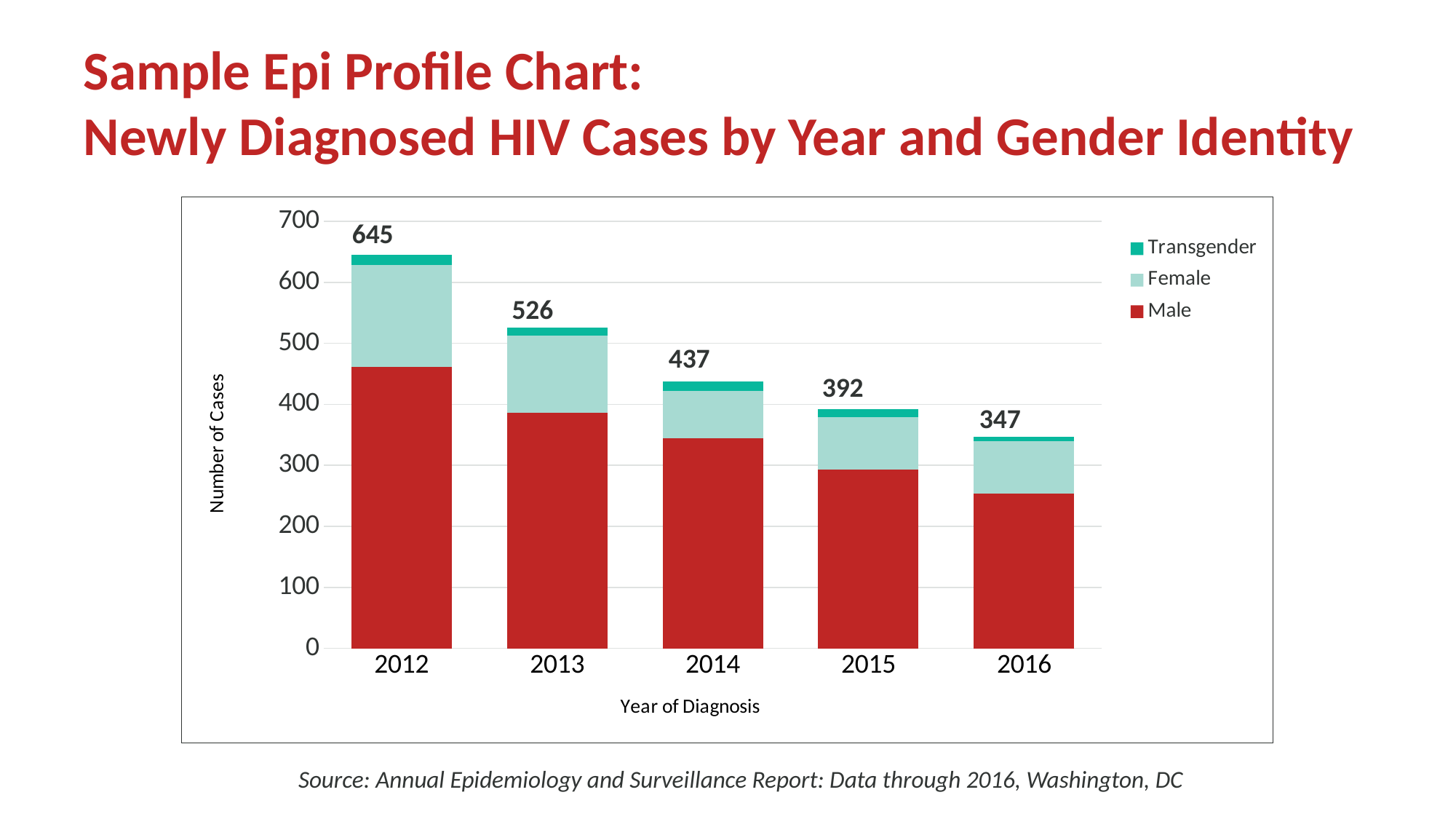
Which year has the lowest total number of cases? 2016 What is the difference between the total cases in 2012 and 2016? 298 What is the total number of newly diagnosed HIV cases in 2016? 347 What is the total number of newly diagnosed HIV cases in 2012? 645 How many series does the legend list? 3 What is the difference between the total cases in 2013 and 2015? 134 How many years are shown on the x axis? 5 Which year has the highest total number of cases? 2012 What is the total number of newly diagnosed HIV cases in 2014? 437 Is the Male value for 2016 greater or less than 300? less Is the Male value for 2012 greater or less than 400? greater Which year has more total cases, 2013 or 2014? 2013